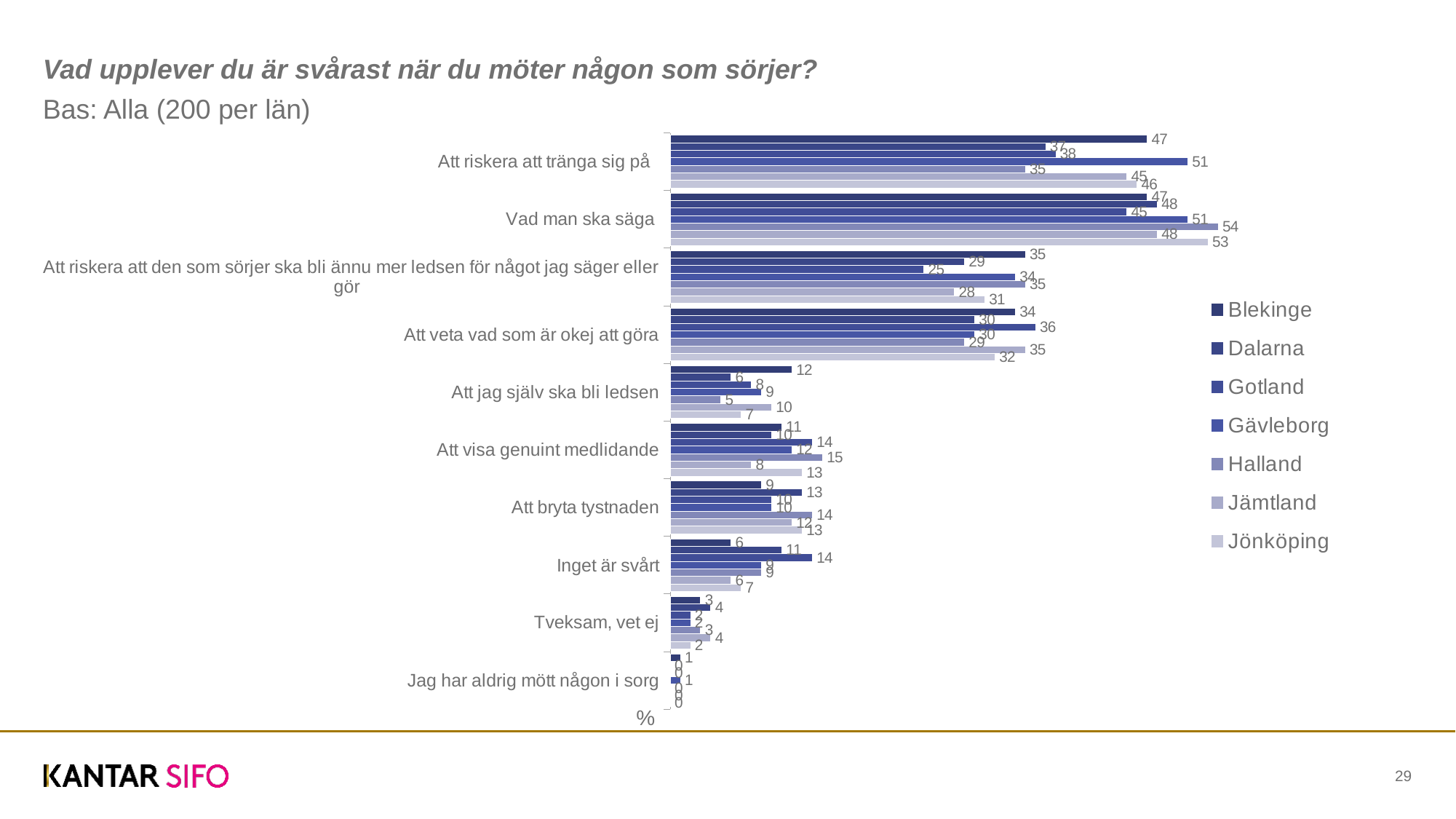
What is the title of the chart on the slide? Vad upplever du är svårast när du möter någon som sörjer? Which county has the highest value for 'Att jag själv ska bli ledsen'? Blekinge Which is larger for 'Att visa genuint medlidande': Halland or Jämtland? Halland What is the value for Gävleborg for 'Att riskera att tränga sig på'? 51 What is the value for Jönköping for 'Vad man ska säga'? 53 How many series does the legend list? 7 How many categories (answer options) are plotted on the chart? 10 Which county has the highest value for 'Vad man ska säga'? Halland What is the value for Halland for 'Vad man ska säga'? 54 What kind of chart is shown on the slide? bar chart What is the value for Blekinge for 'Att riskera att tränga sig på'? 47 What is the difference between Gävleborg and Blekinge for 'Att riskera att tränga sig på'? 4